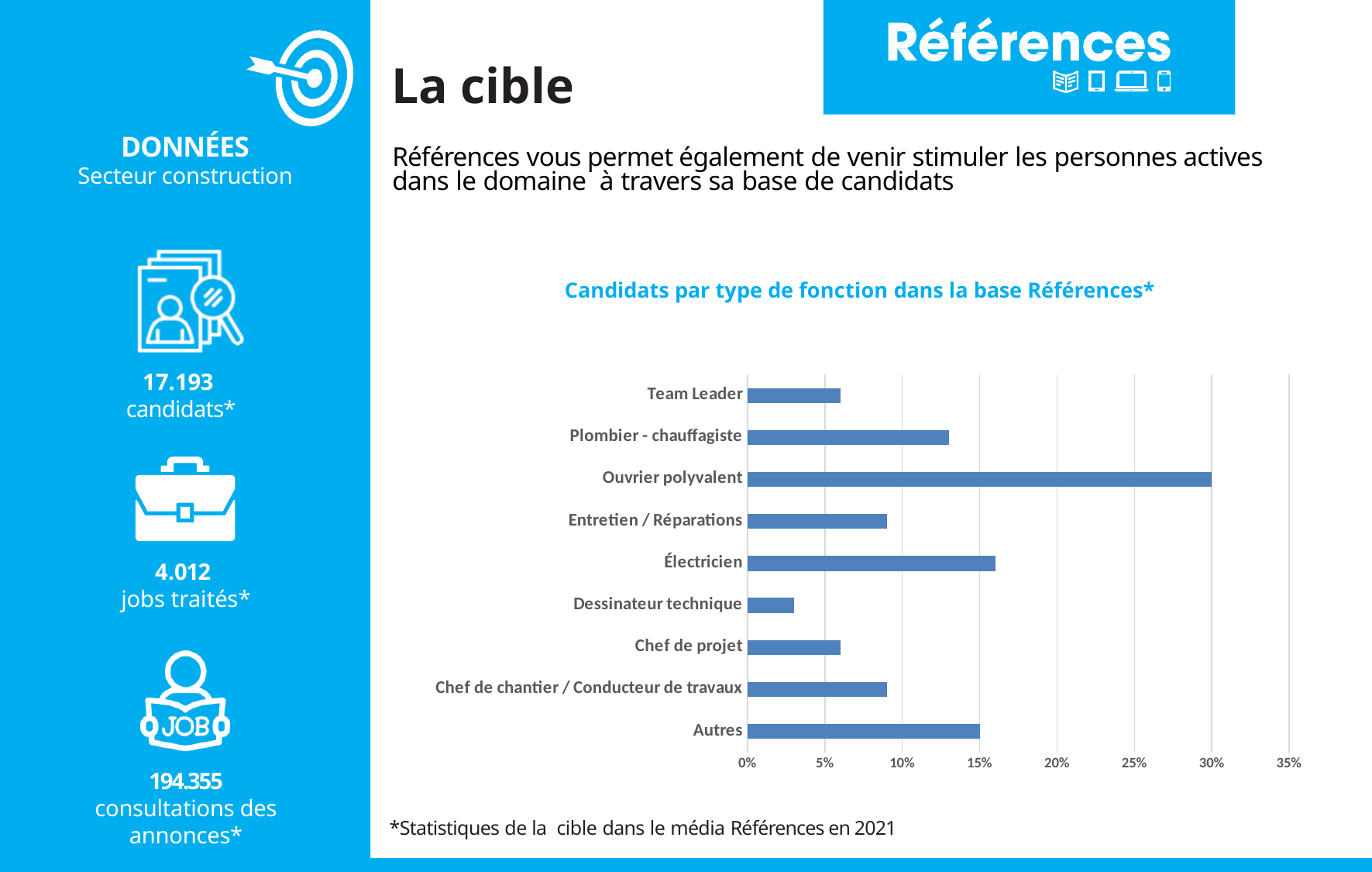
Is the value for Plombier - chauffagiste greater or less than 10%? greater Is the value for Électricien greater or less than 15%? greater Is the value for Entretien / Réparations greater or less than 10%? less Which category has the lowest share of candidates in the chart? Dessinateur technique Which has a larger share of candidates, Plombier - chauffagiste or Électricien? Électricien How many job categories are plotted in the chart? 9 What is the title of the chart? Candidats par type de fonction dans la base Références* What is the value for Ouvrier polyvalent? 30% What kind of chart is shown under the title 'Candidats par type de fonction dans la base Références*'? bar chart Which has a larger share of candidates, Autres or Chef de projet? Autres Which category has the highest share of candidates in the chart? Ouvrier polyvalent